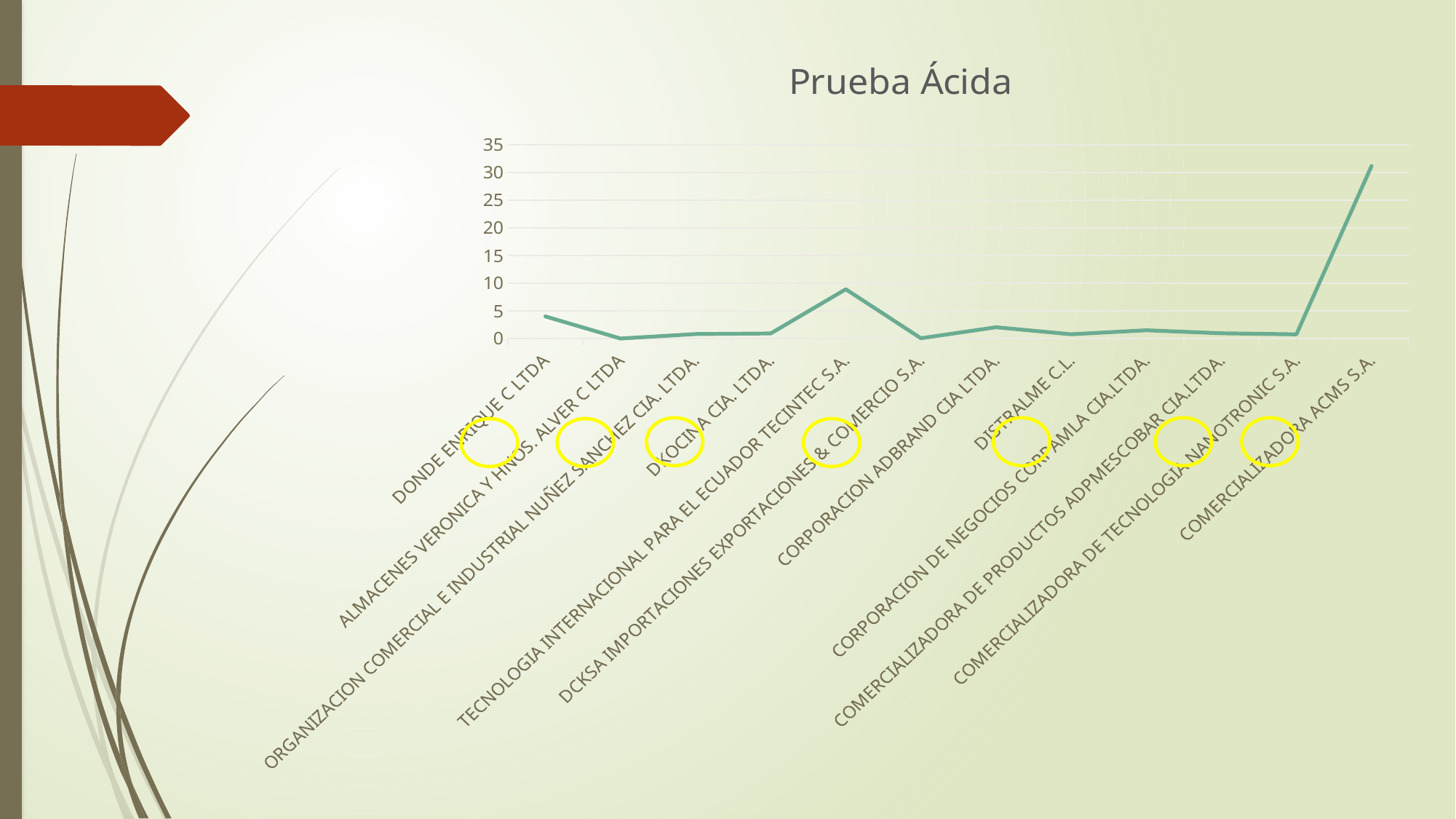
Which has a larger value: TECNOLOGIA INTERNACIONAL PARA EL ECUADOR TECINTEC S.A. or DONDE ENRIQUE C LTDA? TECNOLOGIA INTERNACIONAL PARA EL ECUADOR TECINTEC S.A. Is the value for COMERCIALIZADORA ACMS S.A. greater or less than 25? greater Is the value for TECNOLOGIA INTERNACIONAL PARA EL ECUADOR TECINTEC S.A. greater or less than 5? greater What is the highest value shown on the y axis of the chart? 35 How many companies are plotted along the x axis of the chart? 12 Is the value for DONDE ENRIQUE C LTDA greater or less than 10? less Which has a larger value: COMERCIALIZADORA ACMS S.A. or TECNOLOGIA INTERNACIONAL PARA EL ECUADOR TECINTEC S.A.? COMERCIALIZADORA ACMS S.A. Which company has the highest value in the chart? COMERCIALIZADORA ACMS S.A. Does the line end higher or lower than it starts, comparing the last company to the first? higher What is the title of the chart? Prueba Ácida What type of chart is shown on the slide? line chart